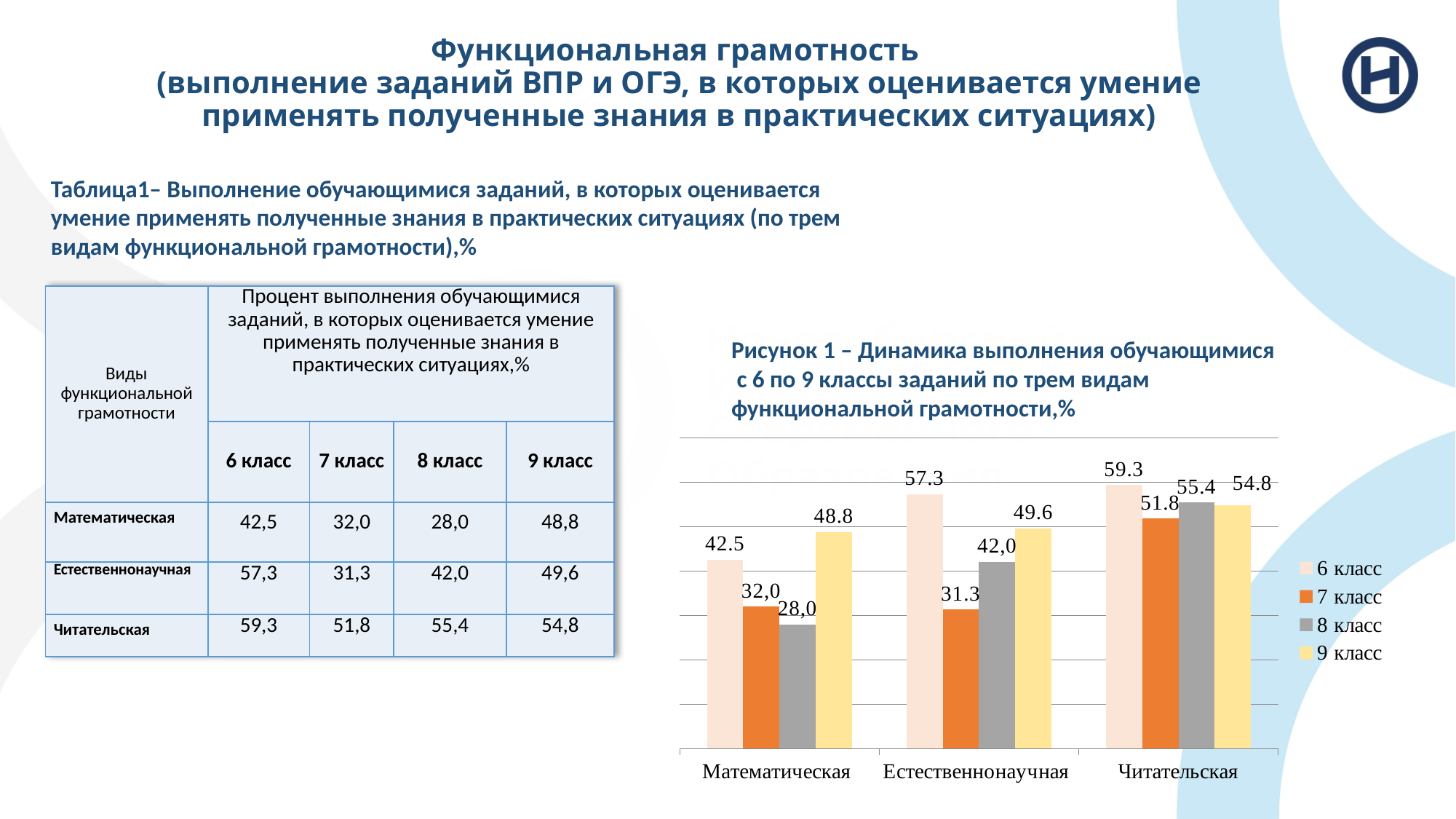
How many series does the chart legend list? 4 Which category has the lowest value for 8 класс? Математическая What is the value for 9 класс in the Читательская category? 54.8 How many categories are shown on the x axis of the chart? 3 Which series is shown in orange in the chart? 7 класс Which category has the highest value for 7 класс? Читательская What is the value for 6 класс in the Математическая category? 42.5 What is the value for 8 класс in the Естественнонаучная category? 42,0 Which series has the highest value in the Читательская category? 6 класс Which is larger in the Математическая category: the value for 9 класс or the value for 6 класс? 9 класс What is the difference between the 6 класс and 7 класс values in the Естественнонаучная category? 26.0 What kind of chart is shown on the slide? bar chart